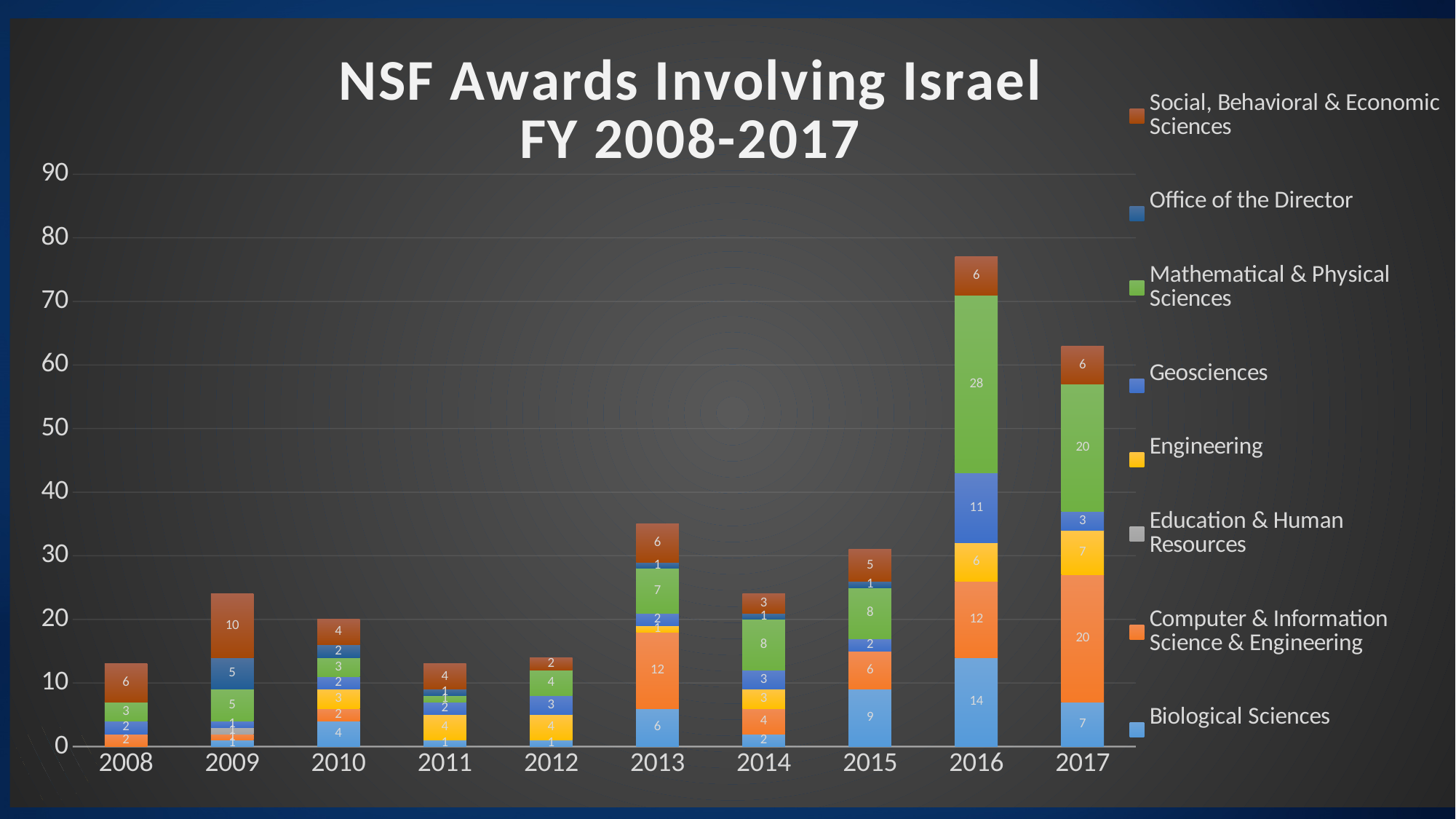
What is the value for Biological Sciences in 2016? 14 What kind of chart is shown on the slide? Stacked bar chart How many years are shown on the x axis? 10 What is the difference between the Mathematical & Physical Sciences values for 2016 and 2017? 8 What is the total of the stacked bar for 2017? 63 How many series does the legend list? 8 Which year has the tallest stacked bar overall? 2016 What is the value for Mathematical & Physical Sciences in 2016? 28 Which year has the larger Biological Sciences value, 2015 or 2017? 2015 What is the value for Social, Behavioral & Economic Sciences in 2009? 10 What is the value for Computer & Information Science & Engineering in 2017? 20 Is the total height of the 2016 bar greater or less than 70? greater